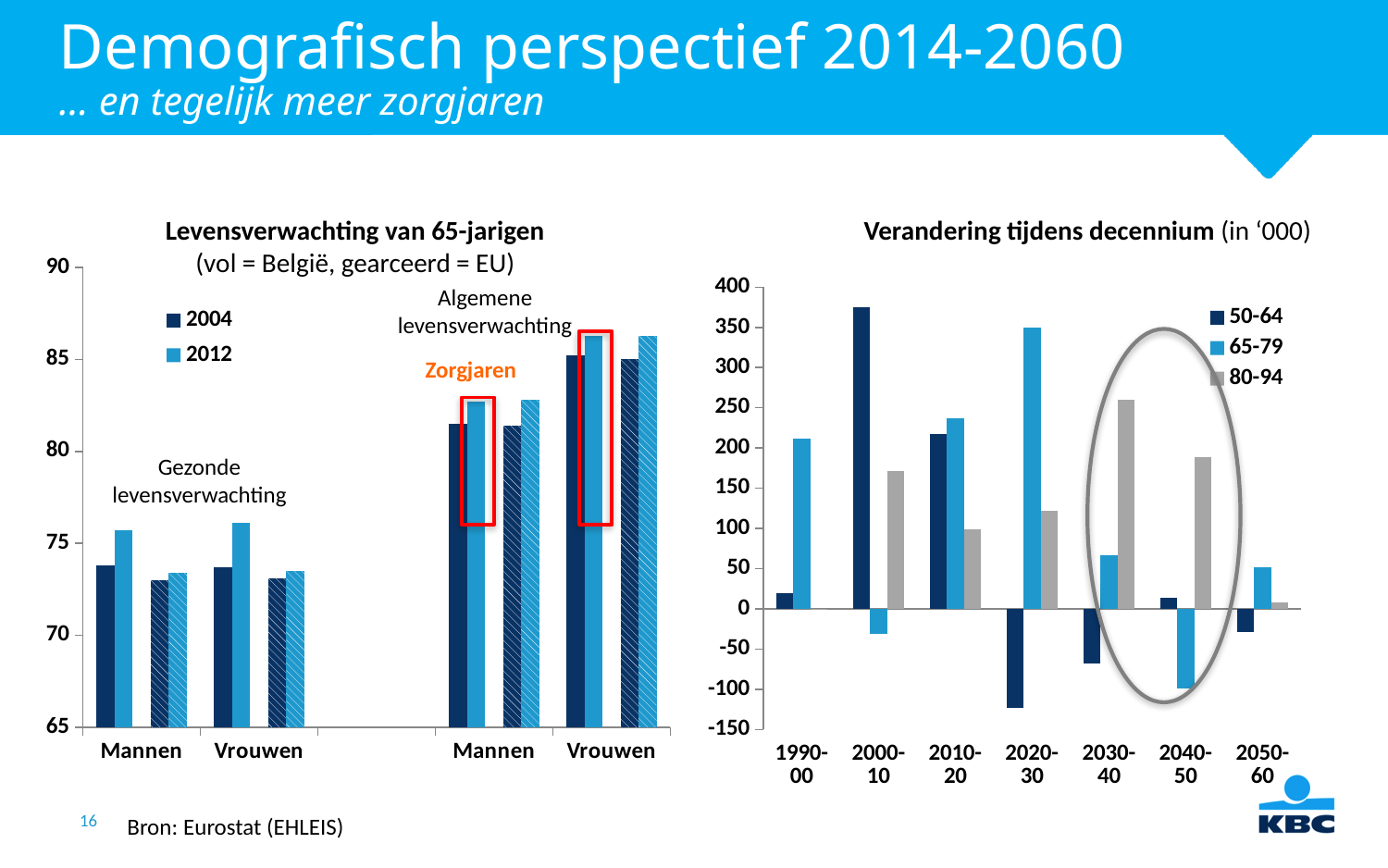
In the right chart 'Verandering tijdens decennium', which decade has the highest value for the 50-64 series? 2000-10 In the right chart 'Verandering tijdens decennium', is the value for 50-64 in 2020-30 greater or less than -100? less In the right chart 'Verandering tijdens decennium', which decade has the highest value for the 80-94 series? 2030-40 How many decades are shown on the x axis of the right chart 'Verandering tijdens decennium'? 7 How many series does the legend of the left chart 'Levensverwachting van 65-jarigen' list? 2 In the right chart 'Verandering tijdens decennium', is the value for 65-79 in 2020-30 greater or less than 300? greater In the left chart 'Levensverwachting van 65-jarigen', under 'Algemene levensverwachting' for 2012 (België), which is larger: Mannen or Vrouwen? Vrouwen In the left chart 'Levensverwachting van 65-jarigen', is the 2012 solid (België) bar for Mannen under 'Gezonde levensverwachting' greater or less than 75? greater In the right chart 'Verandering tijdens decennium', which decade has the lowest value for the 50-64 series? 2020-30 How many series does the legend of the right chart 'Verandering tijdens decennium' list? 3 What kind of chart is the left chart, 'Levensverwachting van 65-jarigen'? bar chart